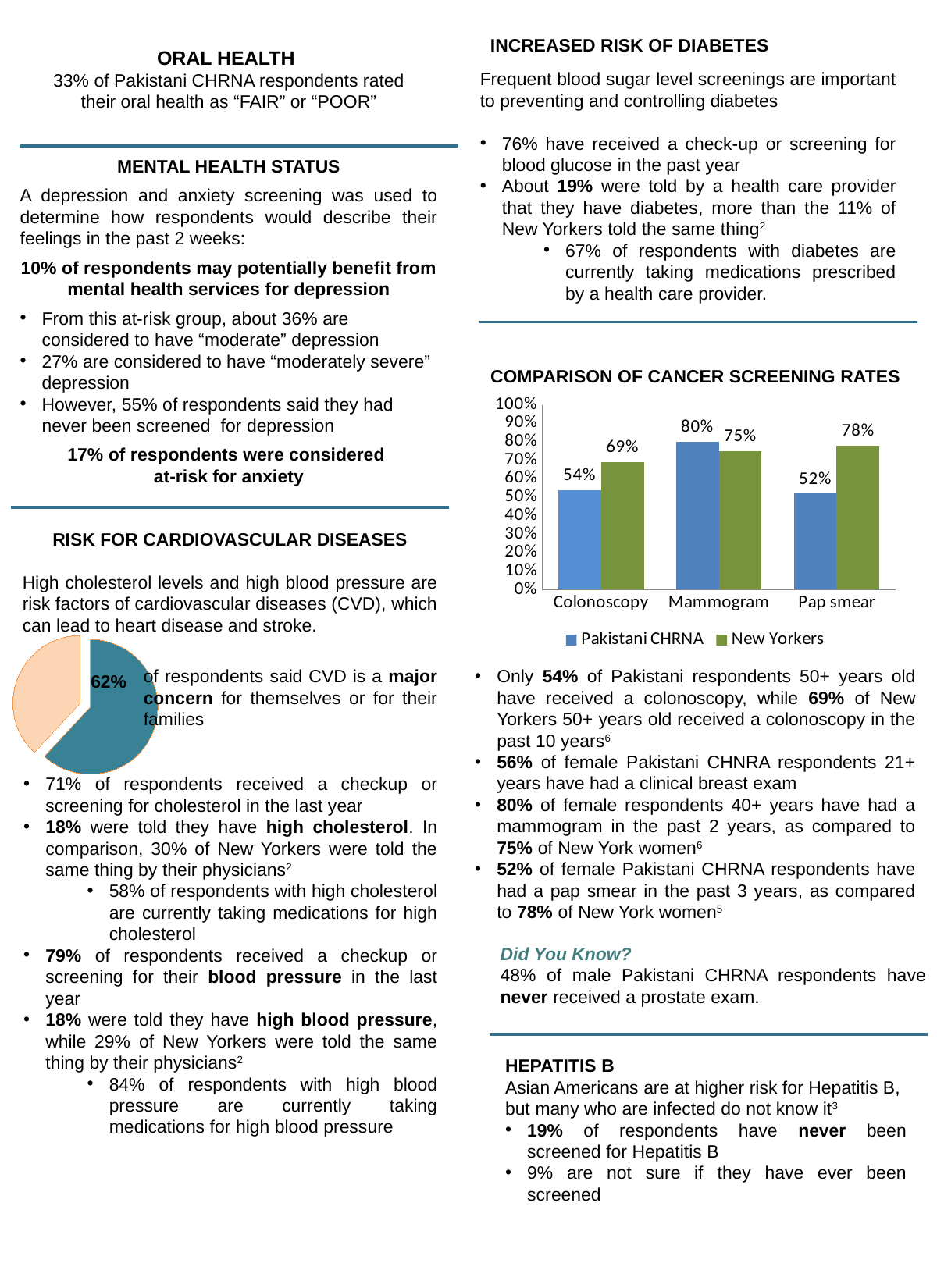
What kind of chart is shown in the 'Risk for Cardiovascular Diseases' section on the left of the slide? Pie chart In the 'Comparison of Cancer Screening Rates' chart, what is the value for Pakistani CHRNA for Colonoscopy? 54% In the 'Comparison of Cancer Screening Rates' chart, which screening has the lowest value for New Yorkers? Colonoscopy What kind of chart is the 'Comparison of Cancer Screening Rates' chart? Bar chart In the 'Comparison of Cancer Screening Rates' chart, how many series does the legend list? 2 In the 'Comparison of Cancer Screening Rates' chart, what is the difference between the New Yorkers and Pakistani CHRNA values for Pap smear? 26% In the 'Comparison of Cancer Screening Rates' chart, what is the value for New Yorkers for Mammogram? 75% In the pie chart in the 'Risk for Cardiovascular Diseases' section, what percentage is printed on the labeled slice? 62% In the 'Comparison of Cancer Screening Rates' chart, what is the value for New Yorkers for Pap smear? 78% In the 'Comparison of Cancer Screening Rates' chart, how many screening categories are shown on the x axis? 3 In the 'Comparison of Cancer Screening Rates' chart, which screening has the highest value for Pakistani CHRNA? Mammogram In the 'Comparison of Cancer Screening Rates' chart, which is larger for Mammogram: Pakistani CHRNA or New Yorkers? Pakistani CHRNA